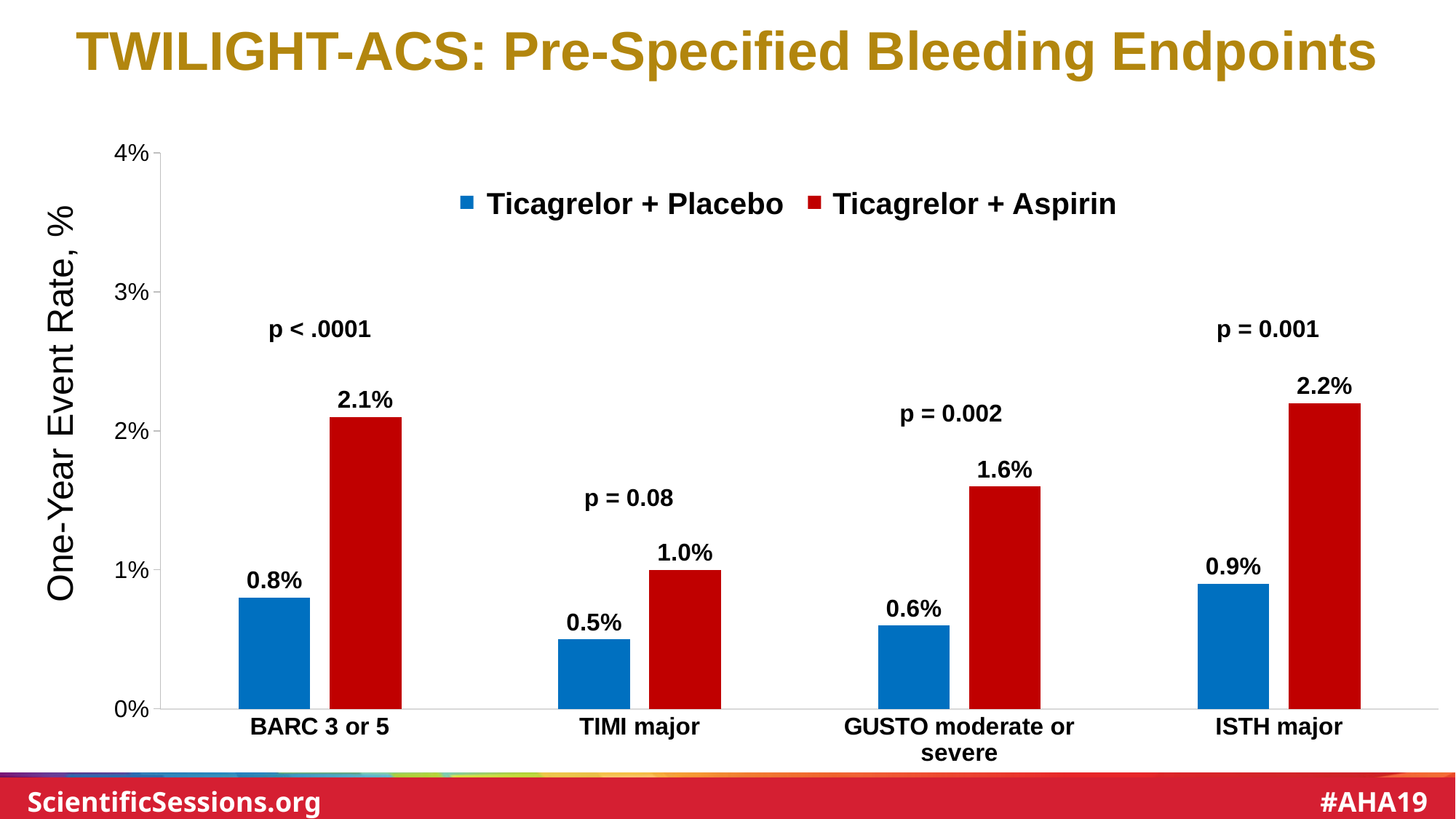
What is the one-year event rate for Ticagrelor + Aspirin for BARC 3 or 5 bleeding? 2.1% For GUSTO moderate or severe bleeding, which group has the higher event rate, Ticagrelor + Placebo or Ticagrelor + Aspirin? Ticagrelor + Aspirin What is the difference between the Ticagrelor + Aspirin and Ticagrelor + Placebo event rates for BARC 3 or 5 bleeding? 1.3% Which bleeding endpoint has the highest event rate for Ticagrelor + Aspirin? ISTH major What is the one-year event rate for Ticagrelor + Placebo for ISTH major bleeding? 0.9% What is the one-year event rate for Ticagrelor + Aspirin for GUSTO moderate or severe bleeding? 1.6% How many bleeding endpoint categories are shown on the x axis? 4 What is the one-year event rate for Ticagrelor + Placebo for TIMI major bleeding? 0.5% Is the Ticagrelor + Aspirin event rate for ISTH major bleeding greater or less than 2%? greater Which bleeding endpoint has the lowest event rate for Ticagrelor + Placebo? TIMI major What kind of chart is shown on the slide? Bar chart How many series does the legend list? 2